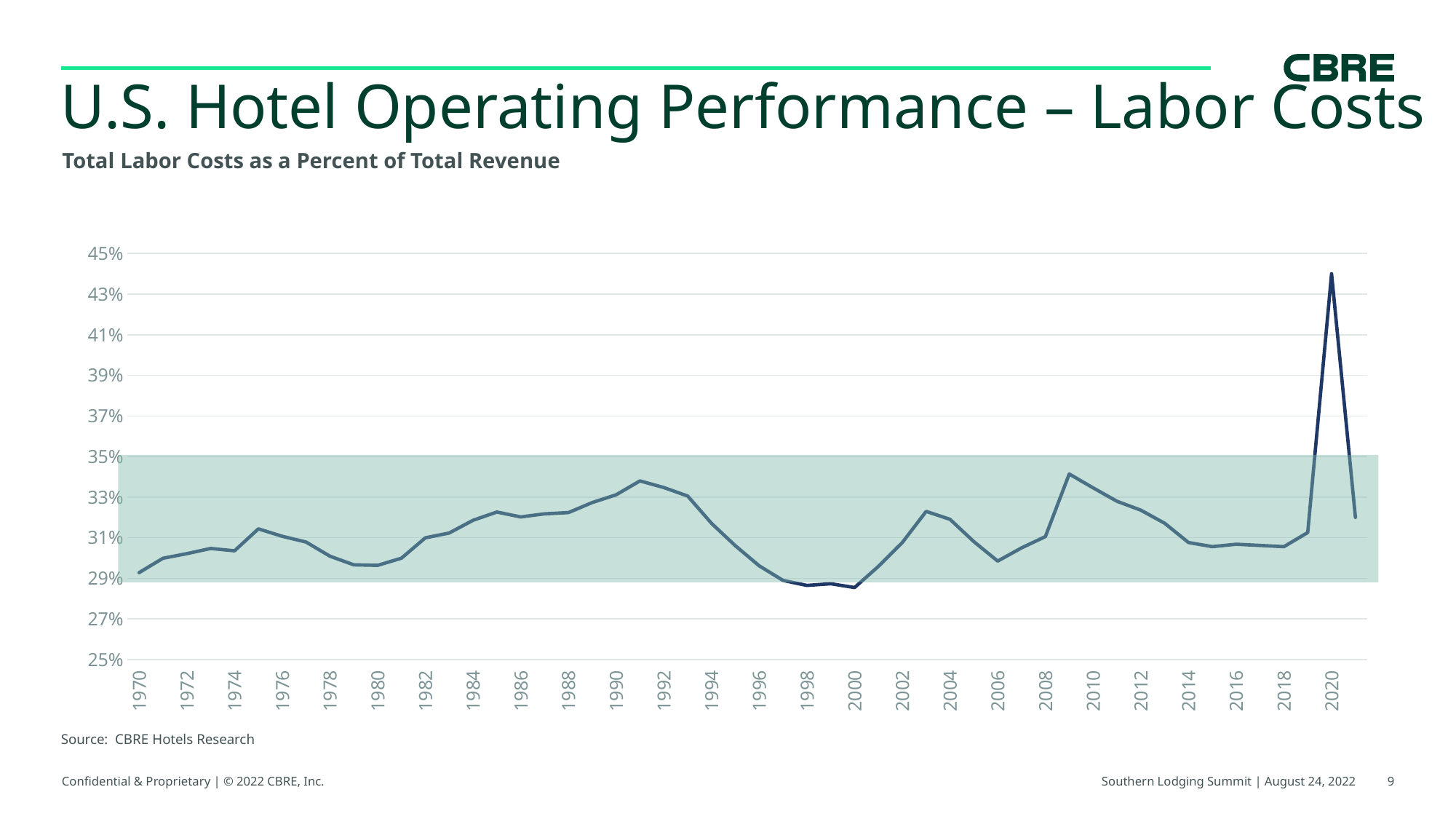
Which year has the larger value, 1991 or 2000? 1991 What kind of chart is shown on the slide? line chart Do the values rise or fall from 1978 to 1991? rise Is the value for 2009 greater or less than 33%? greater Is the value for 2006 greater or less than 31%? less What is the subtitle of the chart? Total Labor Costs as a Percent of Total Revenue Is the value for 2020 greater or less than 43%? greater Which year has the larger value, 2020 or 2009? 2020 Which year has the highest total labor cost as a percent of total revenue? 2020 Do the values rise or fall from 2009 to 2018? fall